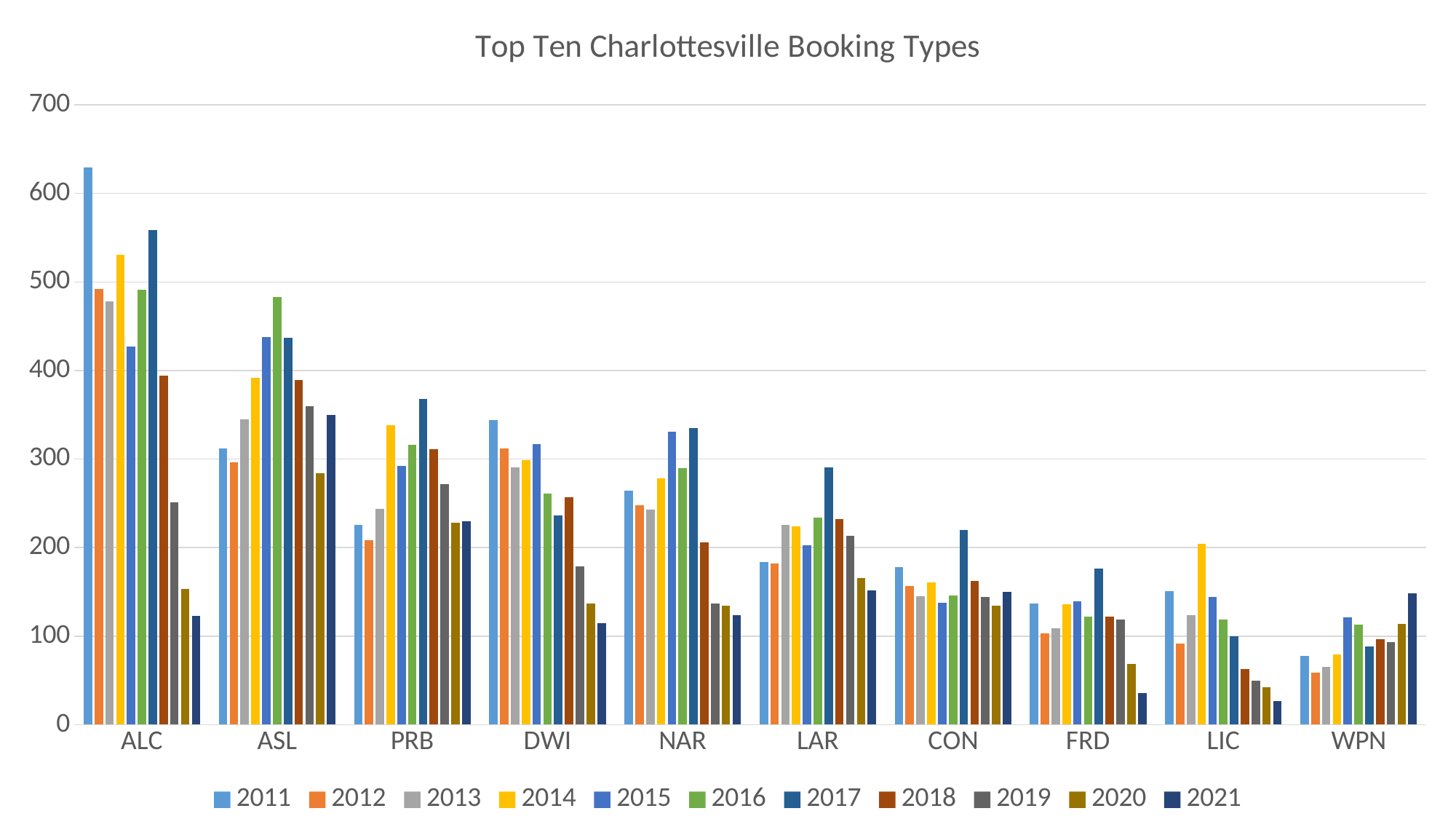
Which year has the lowest bar for ALC? 2021 Which booking type has the highest bar for 2011? ALC How many series does the legend list? 11 Which is larger for 2011: the DWI bar or the NAR bar? DWI What kind of chart is shown on the slide? bar chart What is the title of the chart? Top Ten Charlottesville Booking Types Is the value for LIC in 2014 greater or less than 150? greater How many booking type categories are shown on the x axis? 10 Is the value for WPN in 2021 greater or less than 100? greater For ASL, which is larger: the 2016 bar or the 2011 bar? 2016 Is the value for ALC in 2011 greater or less than 600? greater Do the ALC bars rise or fall from 2018 through 2021? fall